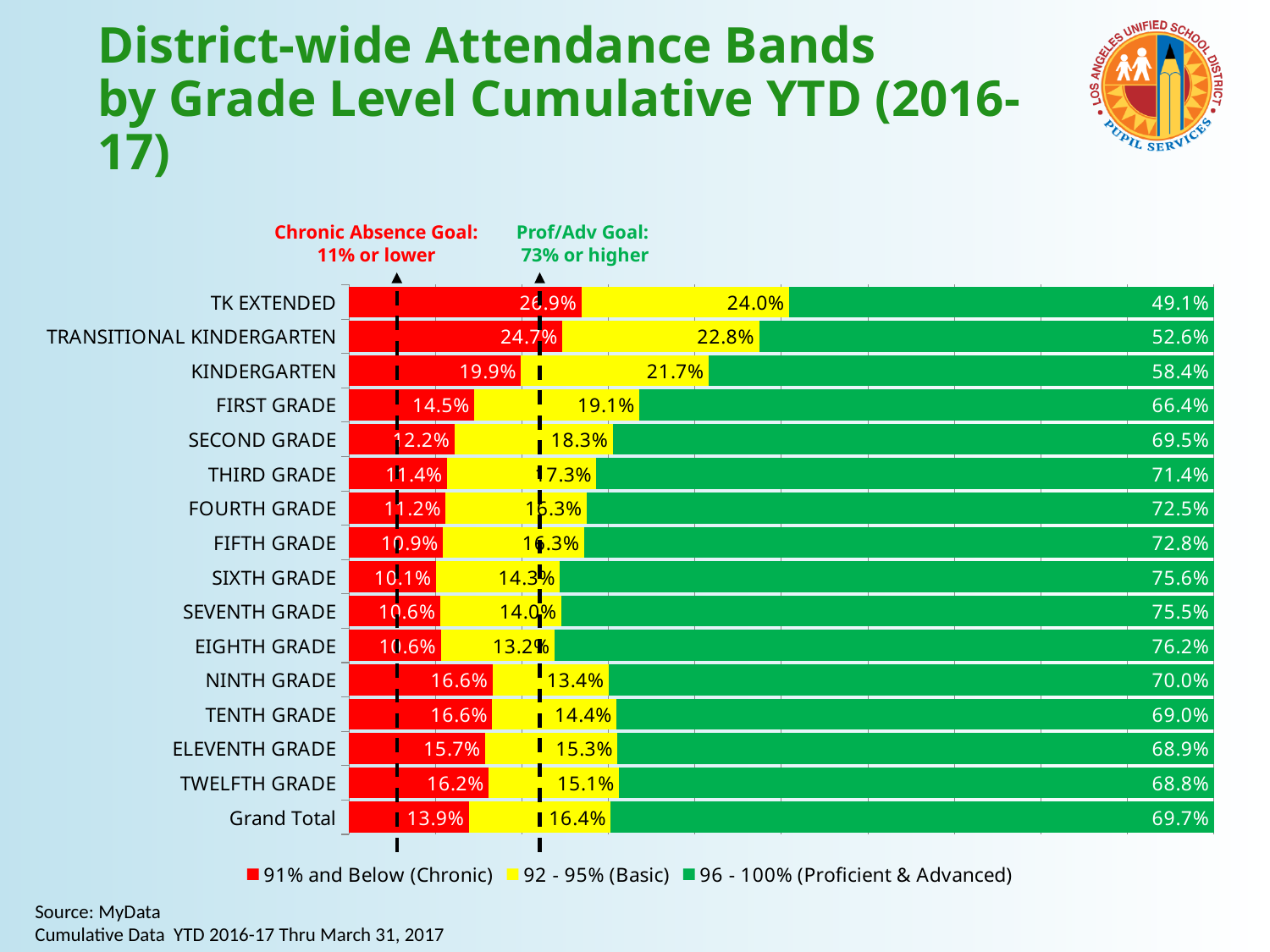
What is the 96 - 100% (Proficient & Advanced) value for EIGHTH GRADE? 76.2% Which category has the highest 96 - 100% (Proficient & Advanced) value? EIGHTH GRADE Which category has the lowest 91% and Below (Chronic) value? SIXTH GRADE How many series does the legend list? 3 Which has a larger 91% and Below (Chronic) value, NINTH GRADE or THIRD GRADE? NINTH GRADE What is the 92 - 95% (Basic) value for the Grand Total? 16.4% What is the Chronic Absence Goal stated above the chart? 11% or lower Which category has the lowest 96 - 100% (Proficient & Advanced) value? TK EXTENDED What is the difference between the 96 - 100% (Proficient & Advanced) values for FIFTH GRADE and FIRST GRADE? 6.4% What is the 91% and Below (Chronic) value for KINDERGARTEN? 19.9% What kind of chart is shown on the slide? Stacked bar chart How many grade-level categories (including Grand Total) are plotted on the chart? 16